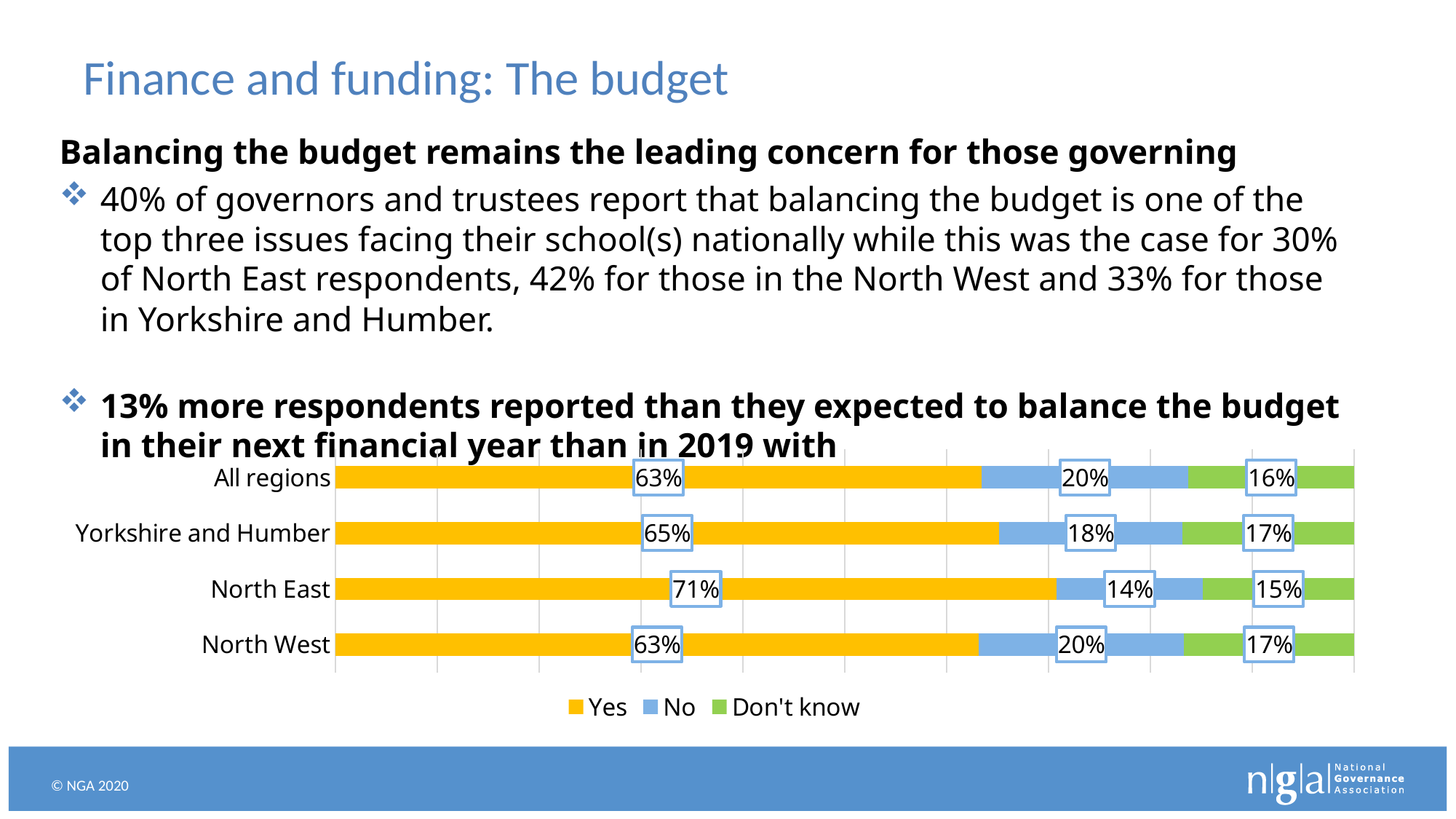
How many series does the legend list? 3 Which region has the highest "Yes" percentage? North East Which colour represents the "Don't know" series in the chart? Green What is the total of the stacked bar for North West? 100% Which region has the lowest "No" percentage? North East What is the "Don't know" value for All regions? 16% How many regions (categories) are shown in the chart? 4 What is the difference between the "Yes" values for North East and All regions? 8% What percentage of North East respondents answered "Yes"? 71% Which is larger, the "Yes" value for Yorkshire and Humber or the "Yes" value for North West? Yorkshire and Humber What is the "No" value for Yorkshire and Humber? 18% What kind of chart is shown on the slide? Stacked bar chart